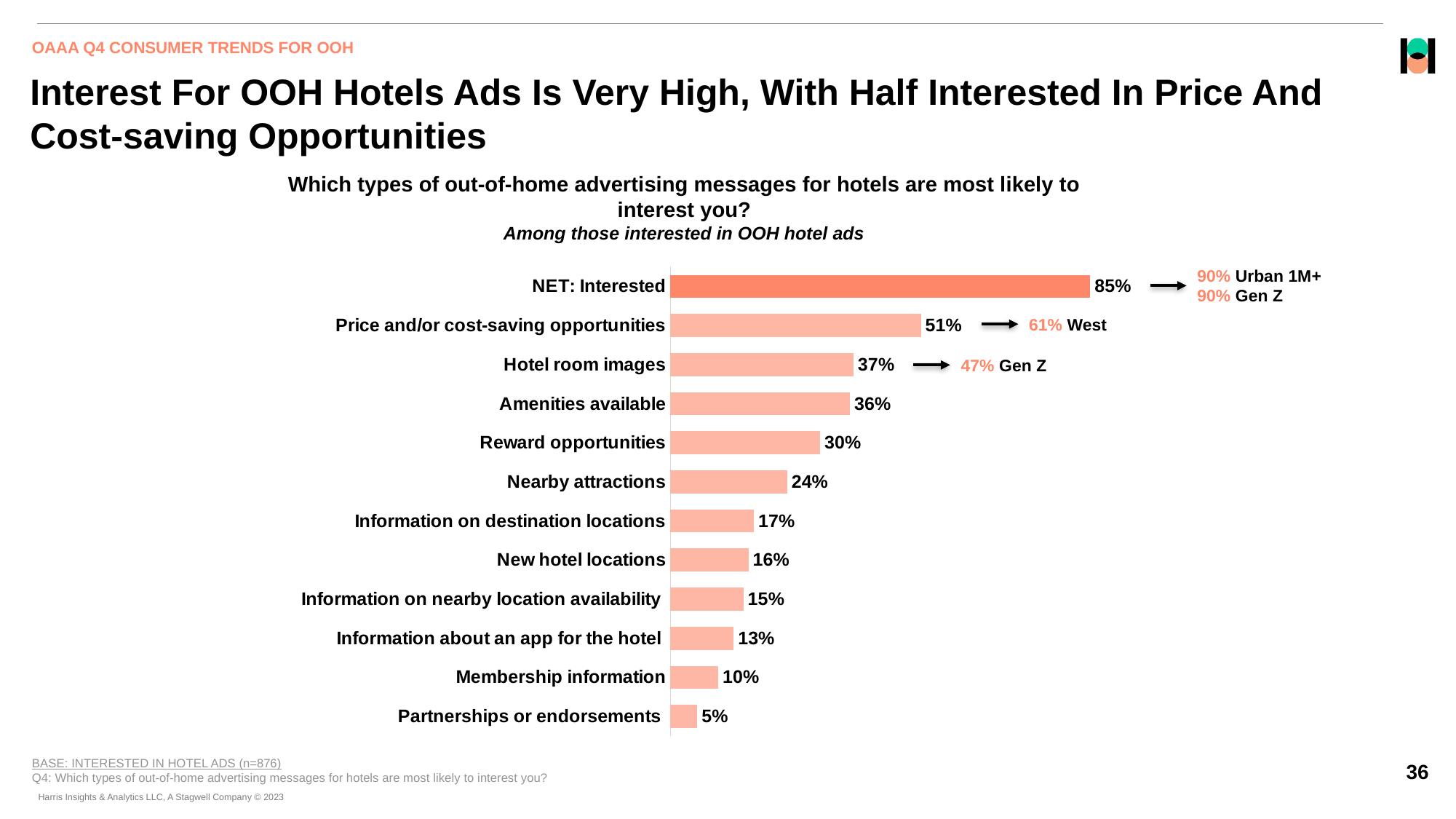
What kind of chart is shown on the slide? Bar chart What is the difference between NET: Interested and Price and/or cost-saving opportunities? 34 percentage points What is the difference between Nearby attractions and Information on destination locations? 7 percentage points Which category has the lowest value? Partnerships or endorsements Which is larger, Amenities available or Reward opportunities? Amenities available What is the value for Membership information? 10% Excluding the NET: Interested bar, which category has the highest value? Price and/or cost-saving opportunities What percentage is shown for Reward opportunities? 30% What is the value for Hotel room images? 37% How many bars are plotted in the chart? 12 What percentage is shown for Price and/or cost-saving opportunities? 51% What value is shown for Gen Z next to the Hotel room images bar? 47%